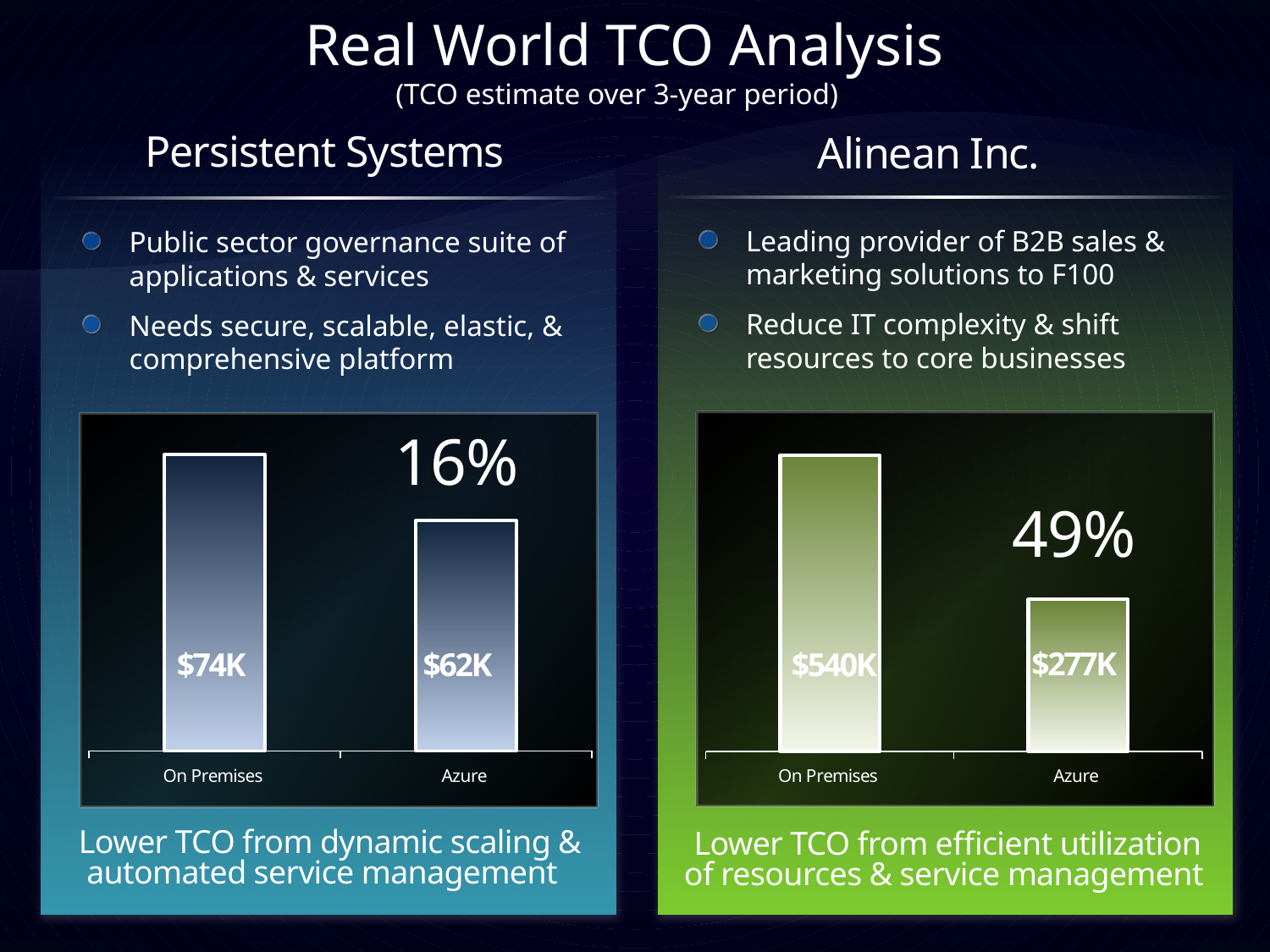
In the Persistent Systems chart, what is the difference between the On Premises and Azure values? $12K How many categories are shown in the Persistent Systems chart? 2 In the Alinean Inc. chart, is the On Premises value larger or smaller than the Azure value? larger In the Alinean Inc. chart, what is the difference between the On Premises and Azure values? $263K In the Alinean Inc. chart, what is the TCO value for On Premises? $540K What kind of chart is used in the Alinean Inc. section? bar chart In the Alinean Inc. chart, which category has the higher TCO? On Premises In the Alinean Inc. chart, what is the TCO value for Azure? $277K In the Persistent Systems chart, what is the TCO value for Azure? $62K In the Persistent Systems chart, what is the TCO value for On Premises? $74K What percentage saving is printed on the Alinean Inc. chart? 49% In the Persistent Systems chart, which category has the lower TCO? Azure